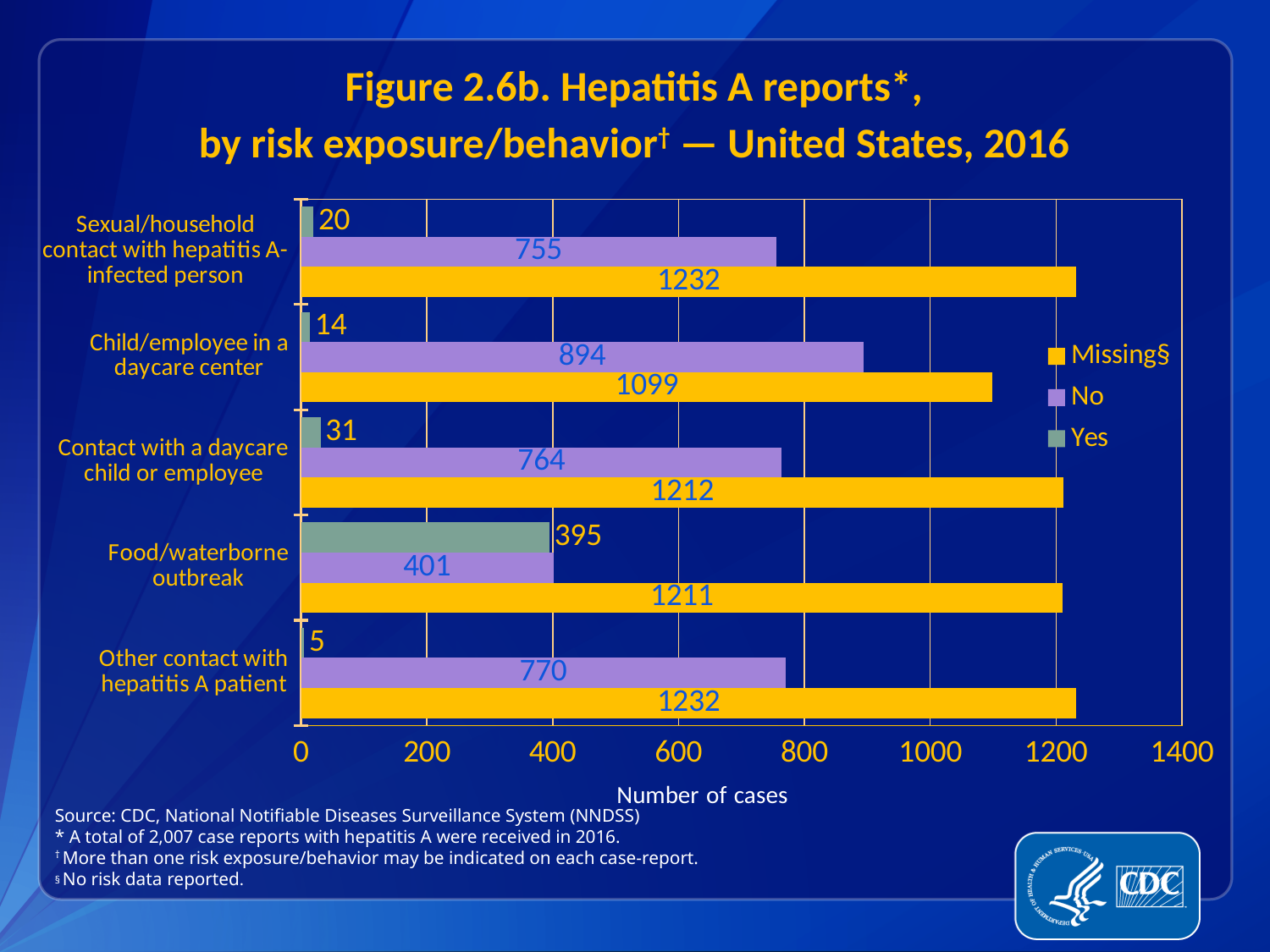
What is the 'Missing' value for Contact with a daycare child or employee? 1212 What is the 'Yes' value for Food/waterborne outbreak? 395 How many series does the legend list? 3 How many risk exposure/behavior categories are shown on the chart? 5 Which is larger: the 'No' value for Child/employee in a daycare center or the 'No' value for Other contact with hepatitis A patient? Child/employee in a daycare center What is the label of the x axis? Number of cases What kind of chart is shown on the slide? Bar chart Is the 'Missing' value for Child/employee in a daycare center greater or less than 1200? less What is the 'No' value for Child/employee in a daycare center? 894 Which risk exposure/behavior has the highest 'Yes' value? Food/waterborne outbreak Which risk exposure/behavior has the lowest 'Yes' value? Other contact with hepatitis A patient What is the difference between the 'No' and 'Yes' values for Food/waterborne outbreak? 6